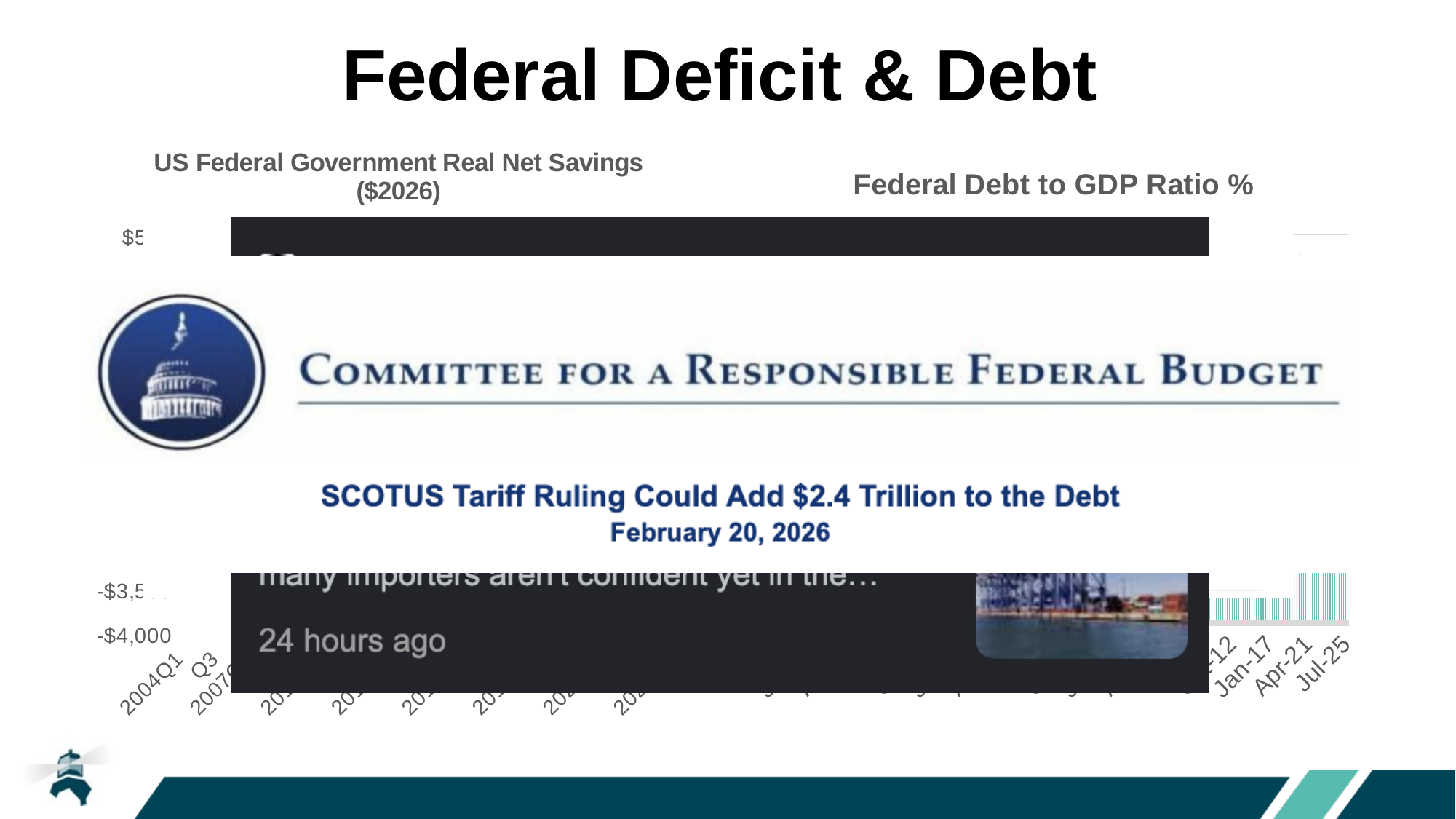
In the Federal Debt to GDP Ratio % chart, what kind of chart is used to plot the data? bar chart What is the title of the chart on the left side of the slide? US Federal Government Real Net Savings ($2026) What is the title of the chart on the right side of the slide? Federal Debt to GDP Ratio % In the Federal Debt to GDP Ratio % chart, do the values rise or fall between Jan-17 and Jul-25? rise